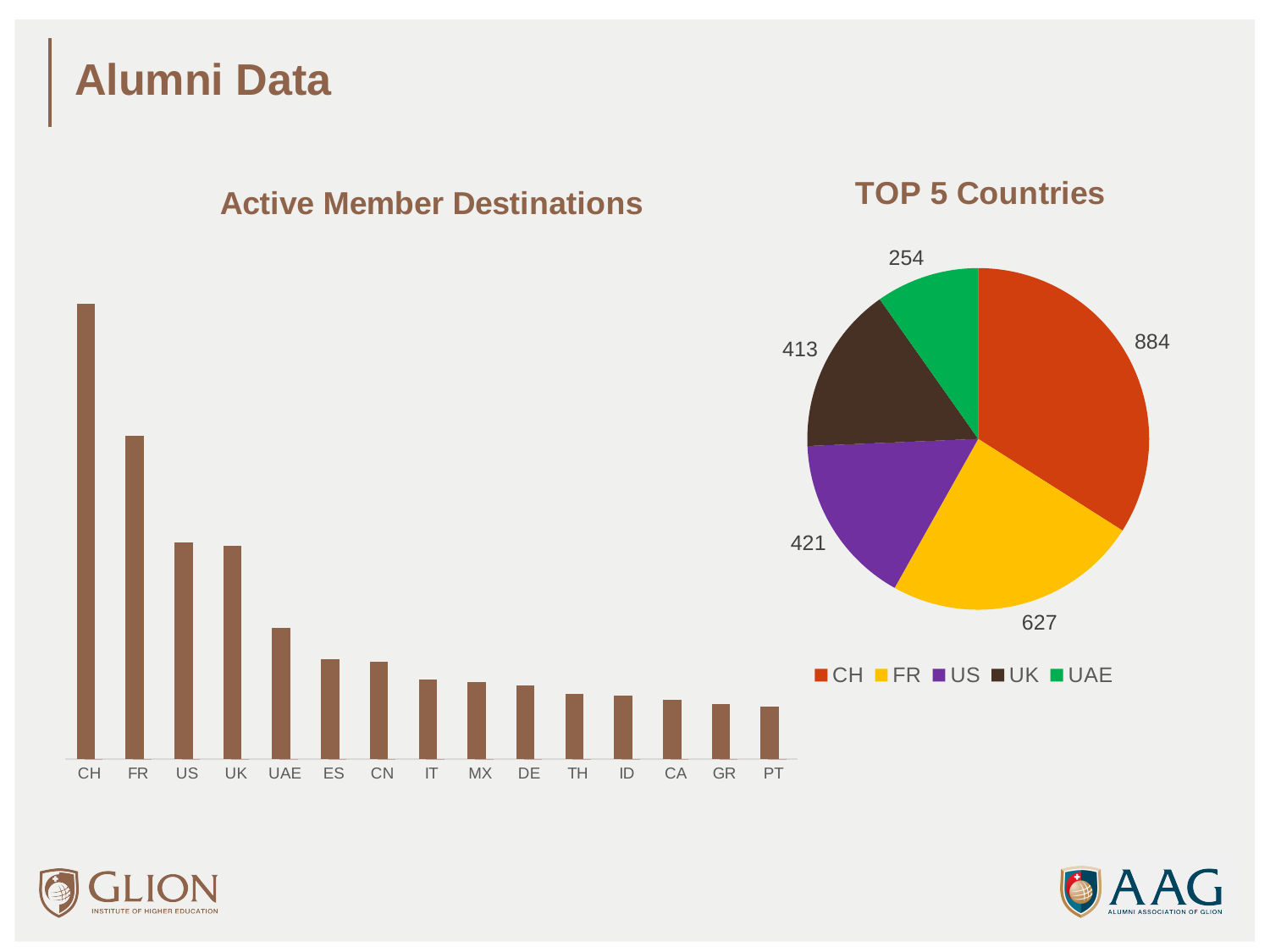
In the Active Member Destinations chart, which destination has the shortest bar? PT In the Active Member Destinations chart, which destination has the tallest bar? CH In the TOP 5 Countries pie chart, what is the value for CH? 884 In the TOP 5 Countries pie chart, which country has the smallest slice? UAE In the TOP 5 Countries pie chart, what is the value for UAE? 254 In the TOP 5 Countries pie chart, what is the difference between the values for CH and FR? 257 In the TOP 5 Countries pie chart, which country has the largest slice? CH What kind of chart is the Active Member Destinations chart? Bar chart In the TOP 5 Countries pie chart, how many entries does the legend list? 5 In the TOP 5 Countries pie chart, what is the value for UK? 413 In the Active Member Destinations chart, how many destinations are shown on the x axis? 15 In the Active Member Destinations chart, which is larger, the bar for FR or the bar for UAE? FR